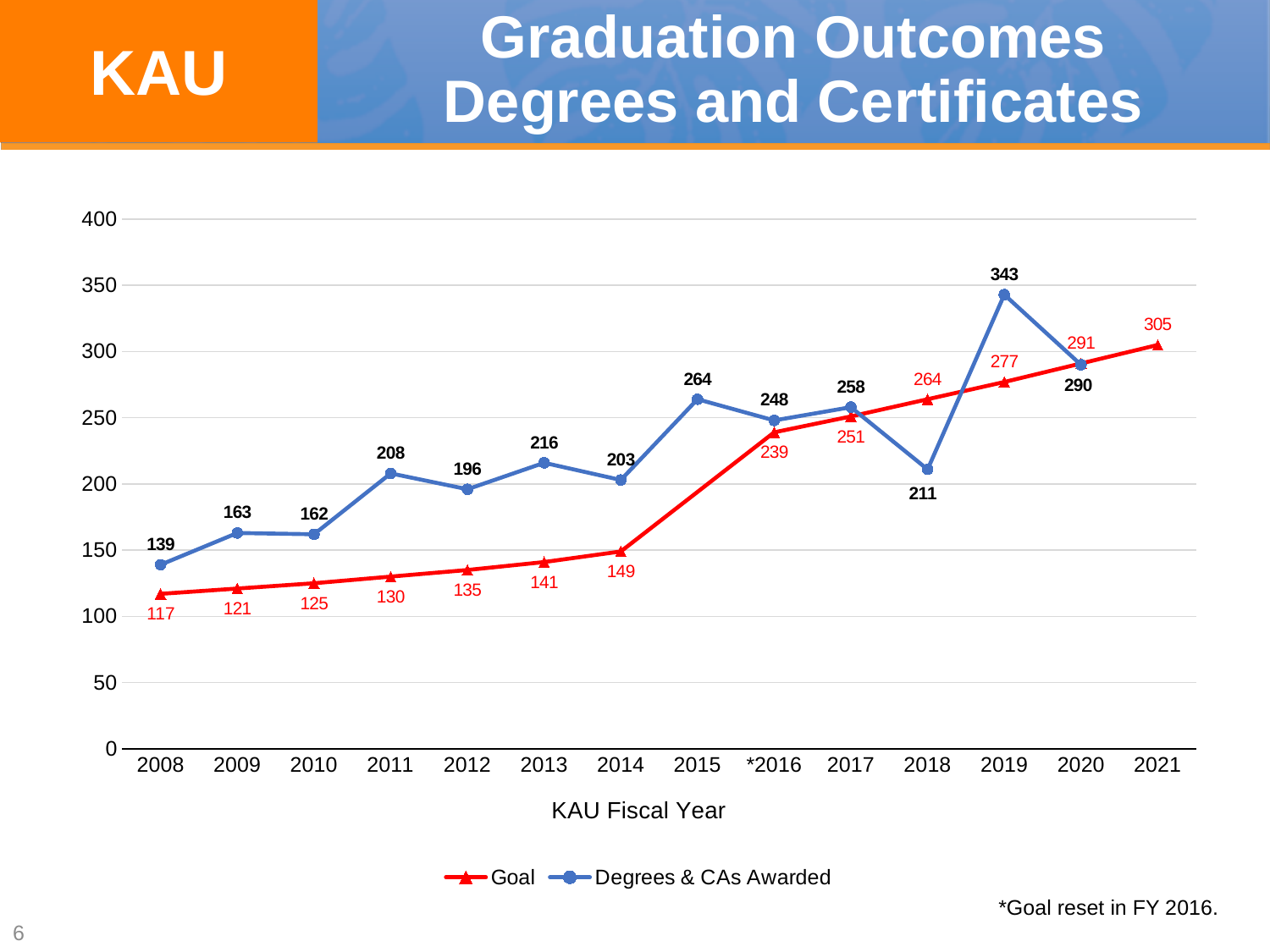
What is the Goal value for 2021? 305 How many series does the legend list? 2 In 2018, which was larger: the Goal or Degrees & CAs Awarded? Goal How many Degrees & CAs were awarded in 2012? 196 How many fiscal years are shown on the x axis? 14 How many Degrees & CAs were awarded in 2019? 343 In which fiscal year was the number of Degrees & CAs Awarded lowest? 2008 Is the number of Degrees & CAs Awarded in 2015 greater or less than 250? greater In which fiscal year was the number of Degrees & CAs Awarded highest? 2019 By how much did Degrees & CAs Awarded exceed the Goal in 2019? 66 What kind of chart is shown on the slide? Line chart What is the difference between the Goal and Degrees & CAs Awarded in 2020? 1